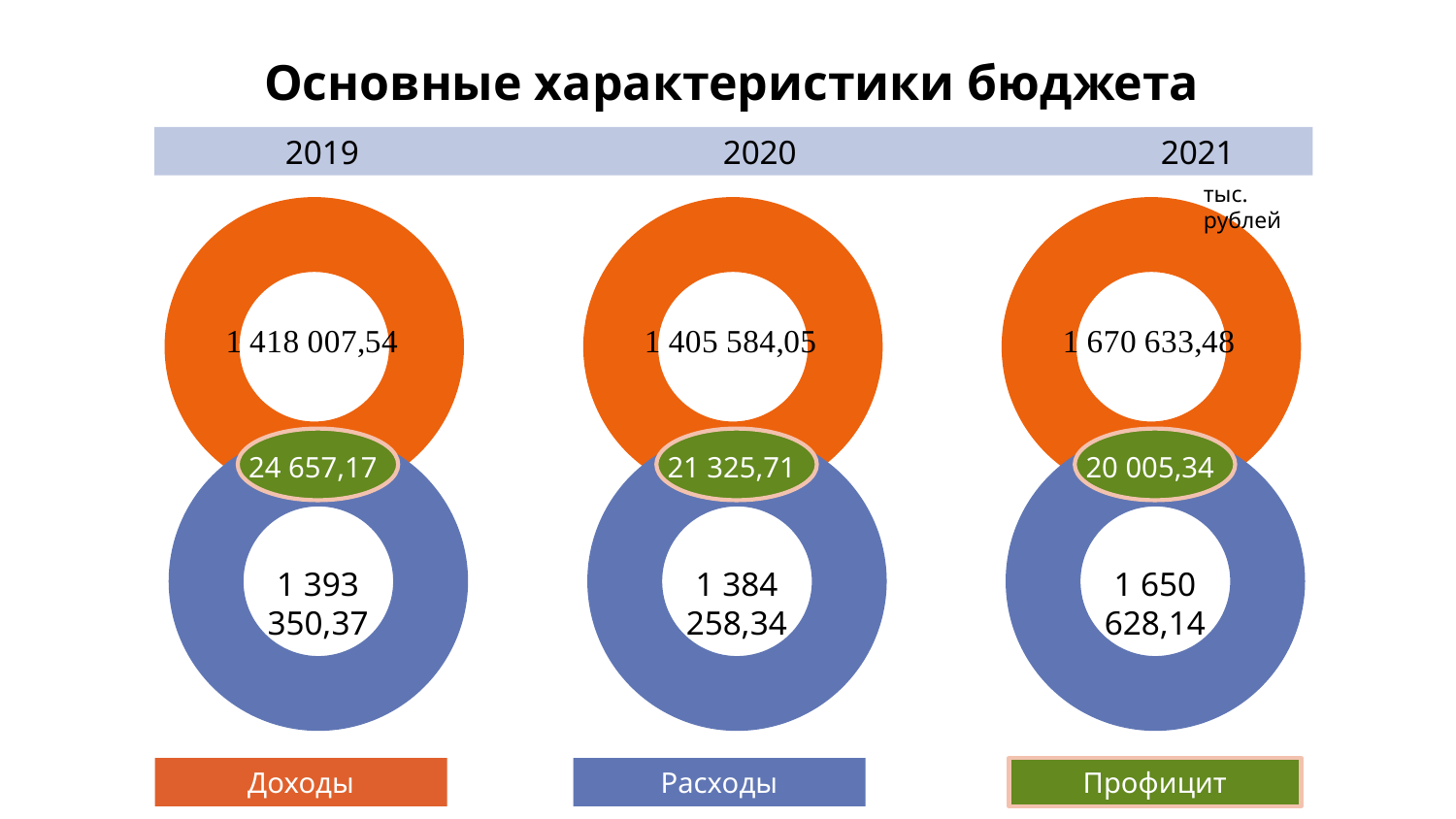
Which year has the highest Доходы (income)? 2021 What is the value of Профицит (surplus) for 2021? 20 005,34 What is the difference between Доходы and Расходы for 2020? 21 325,71 Which year has the lowest Расходы (expenses)? 2020 Is the Профицит (surplus) larger in 2019 or in 2020? 2019 Does the Профицит (surplus) rise or fall from 2019 to 2021? fall How many years are shown on the slide? 3 What is the value of Доходы (income) for 2019? 1 418 007,54 What is the value of Доходы (income) for 2021? 1 670 633,48 Which year has the lowest Профицит (surplus)? 2021 In what units are the values on the slide given? тыс. рублей What is the value of Расходы (expenses) for 2020? 1 384 258,34